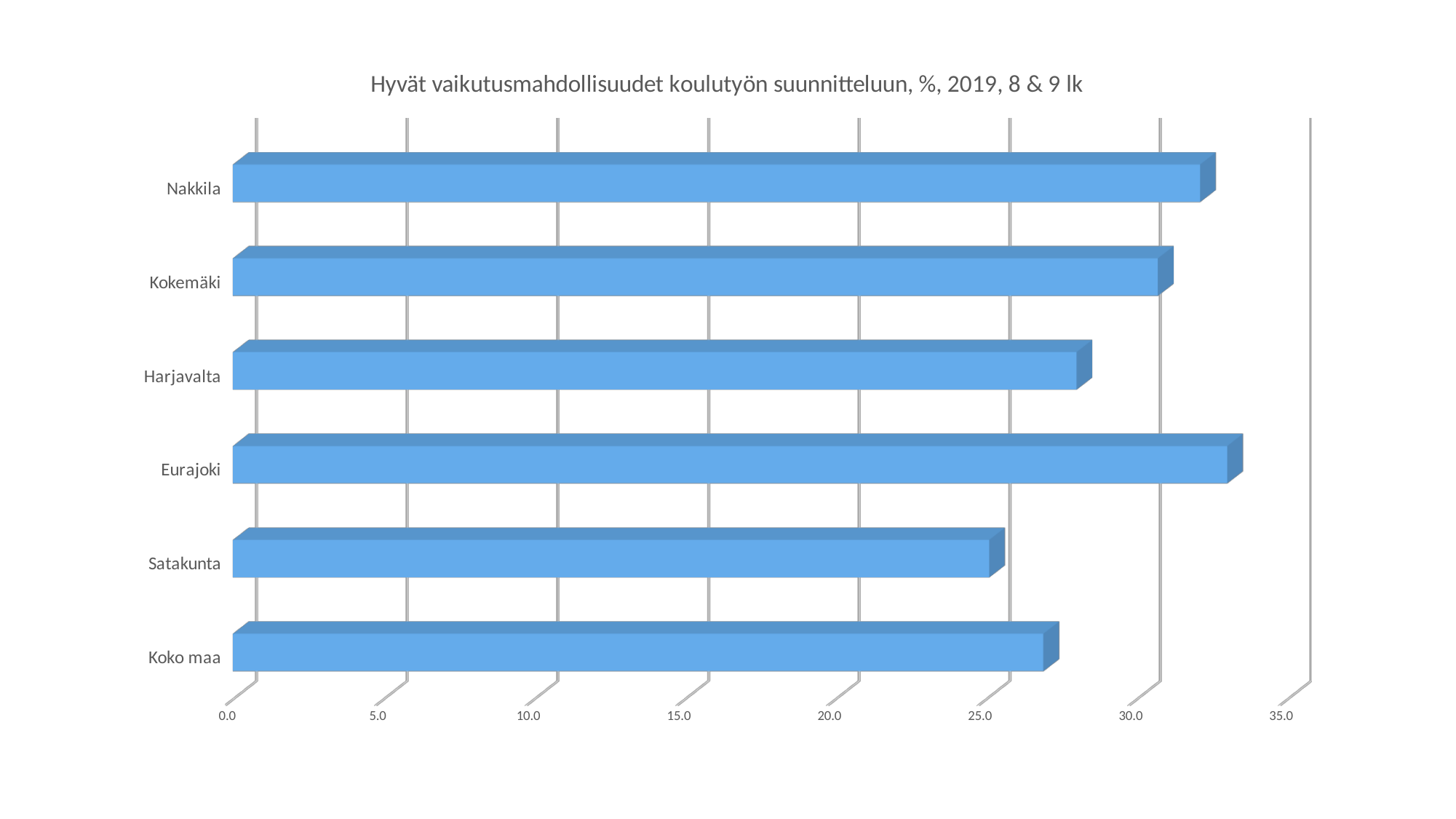
Is the value for Satakunta greater or less than 30.0? less Which has a larger value, Nakkila or Kokemäki? Nakkila How many categories are shown in the chart? 6 Is the value for Koko maa greater or less than 30.0? less Is the value for Eurajoki greater or less than 30.0? greater Which has a larger value, Harjavalta or Koko maa? Harjavalta Which category has the highest value? Eurajoki Which category has the lowest value? Satakunta What type of chart is shown on the slide? bar chart What is the title of the chart? Hyvät vaikutusmahdollisuudet koulutyön suunnitteluun, %, 2019, 8 & 9 lk